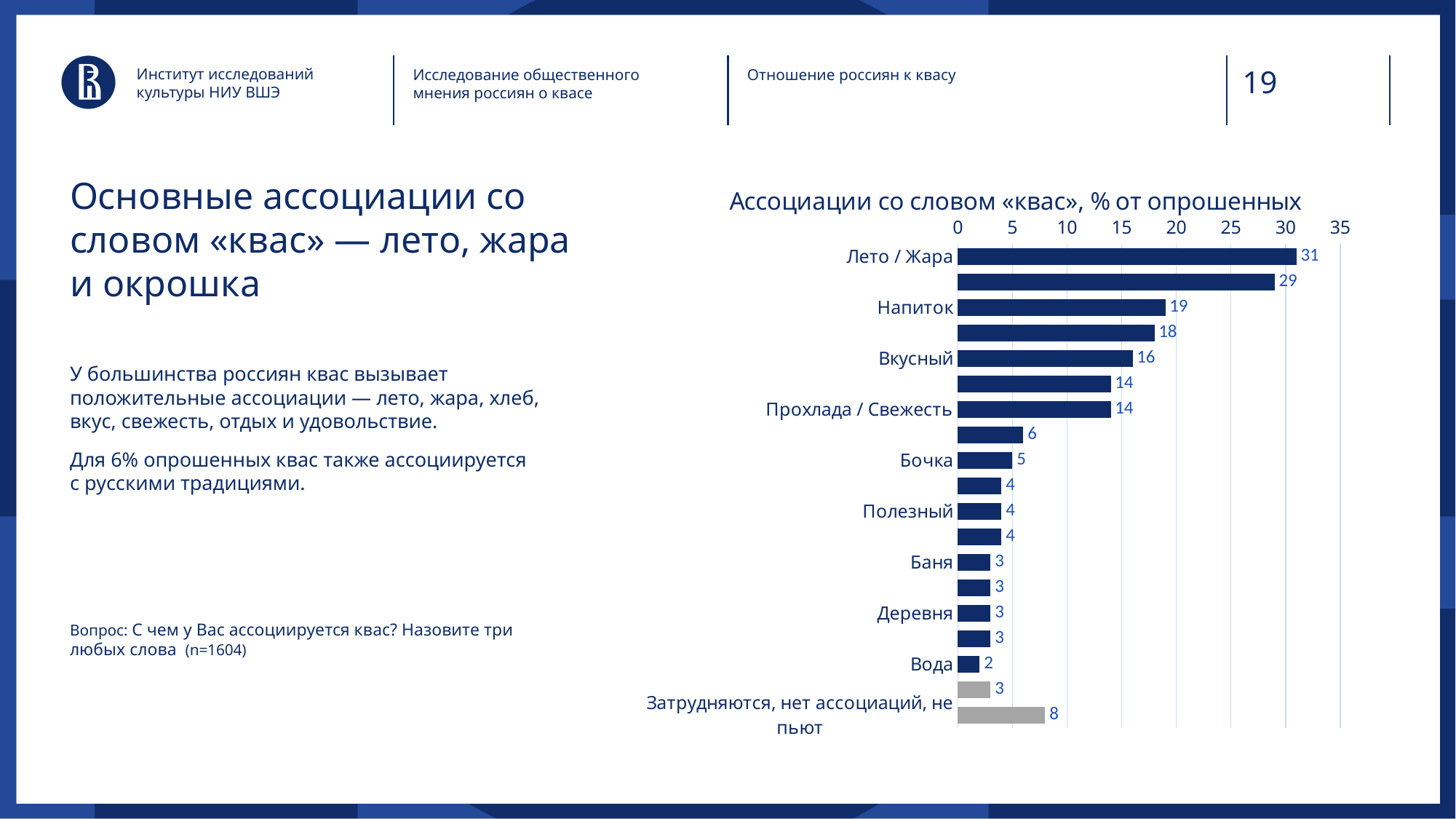
What is the value for Лето / Жара? 31 Which labelled category has the lowest value? Вода What is the value for Напиток? 19 Which labelled category has the highest value? Лето / Жара What is the title of the chart? Ассоциации со словом «квас», % от опрошенных What is the value for Затрудняются, нет ассоциаций, не пьют? 8 What is the value for Прохлада / Свежесть? 14 Which is larger, the value for Бочка or the value for Полезный? Бочка What is the value for Вкусный? 16 What is the difference between the values for Лето / Жара and Напиток? 12 What is the value for Вода? 2 What is the value for Бочка? 5